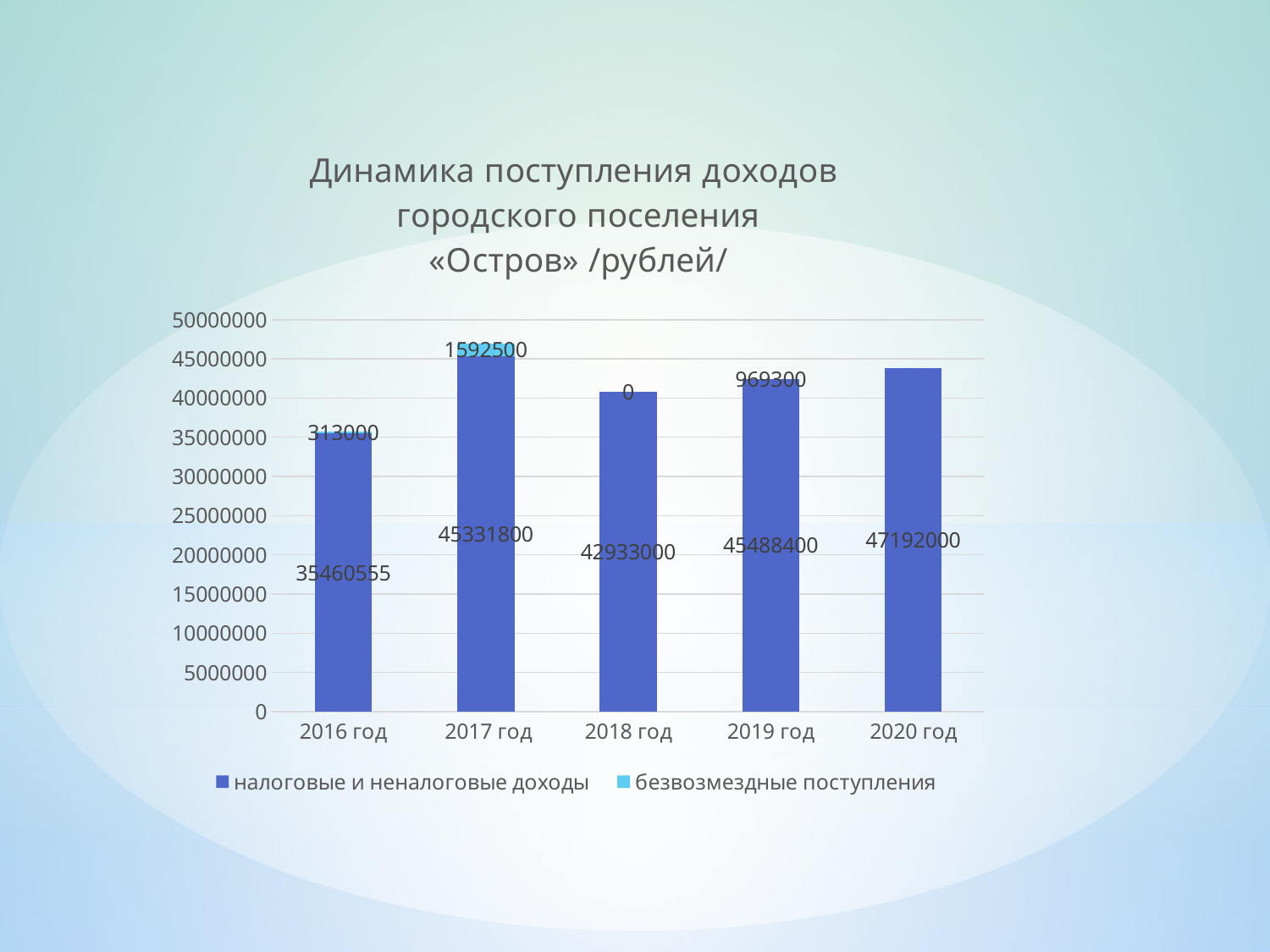
What is the difference between налоговые и неналоговые доходы in 2020 год and 2019 год? 1703600 What is the value of безвозмездные поступления for 2017 год? 1592500 What is the total of the stacked bar for 2016 год? 35773555 What is the value of налоговые и неналоговые доходы for 2020 год? 47192000 Which year has the highest value of безвозмездные поступления? 2017 год How many series does the legend list? 2 How many years are shown on the x axis? 5 Which year has the lowest value of налоговые и неналоговые доходы? 2016 год What is the value of налоговые и неналоговые доходы for 2016 год? 35460555 What is the value of безвозмездные поступления for 2018 год? 0 Which is larger, налоговые и неналоговые доходы in 2017 год or in 2018 год? 2017 год